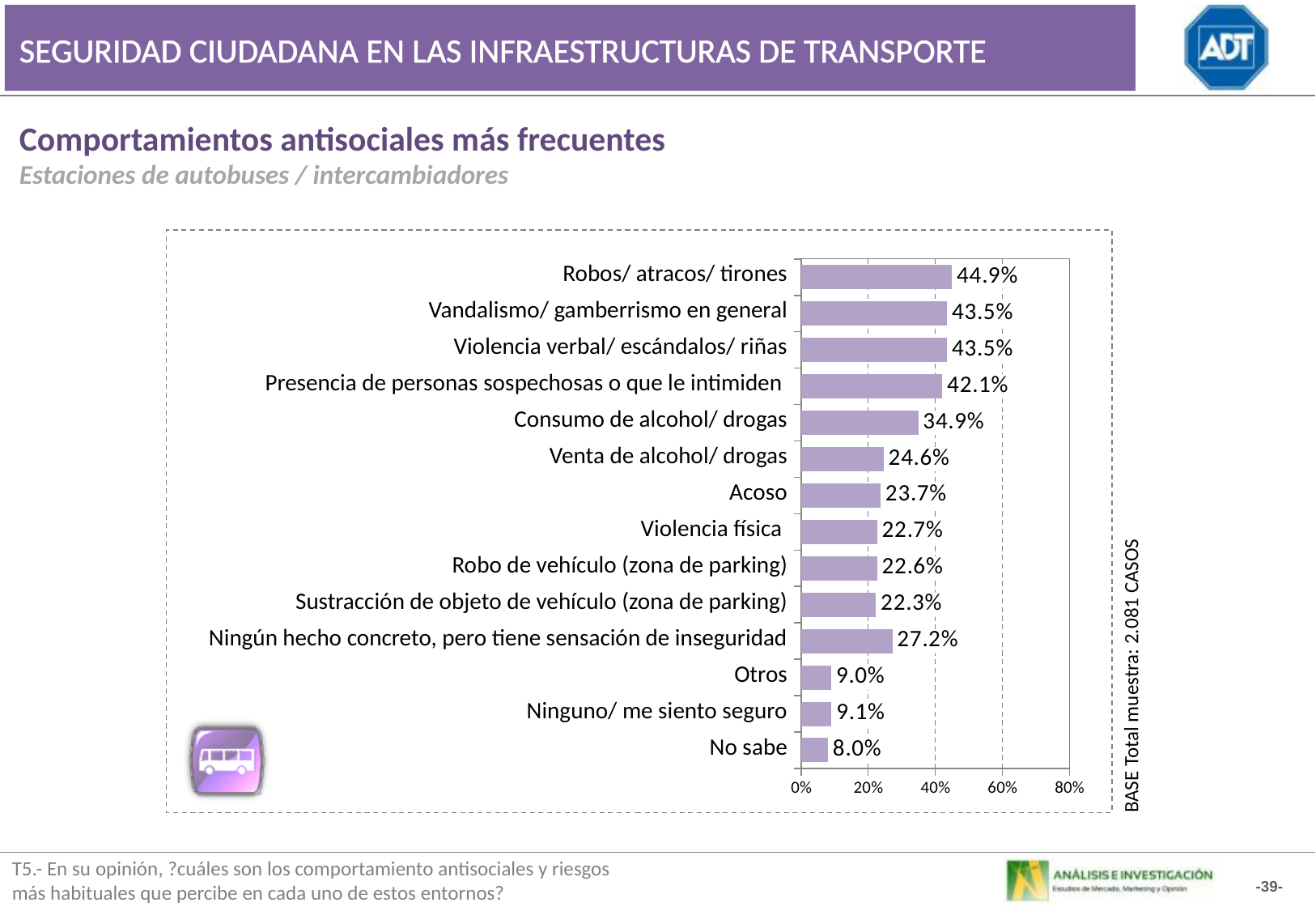
Which category has the lowest value? No sabe Is the value for Presencia de personas sospechosas o que le intimiden greater or less than 40%? greater Which category has the highest value? Robos/ atracos/ tirones What is the difference between Consumo de alcohol/ drogas and Venta de alcohol/ drogas? 10.3% What kind of chart is shown on the slide? Bar chart What is the value for Robos/ atracos/ tirones? 44.9% How many categories are shown in the chart? 14 What is the value for Ningún hecho concreto, pero tiene sensación de inseguridad? 27.2% Which is larger, Acoso or Violencia física? Acoso What is the value for No sabe? 8.0% What is the difference between Robos/ atracos/ tirones and Vandalismo/ gamberrismo en general? 1.4% What is the value for Consumo de alcohol/ drogas? 34.9%